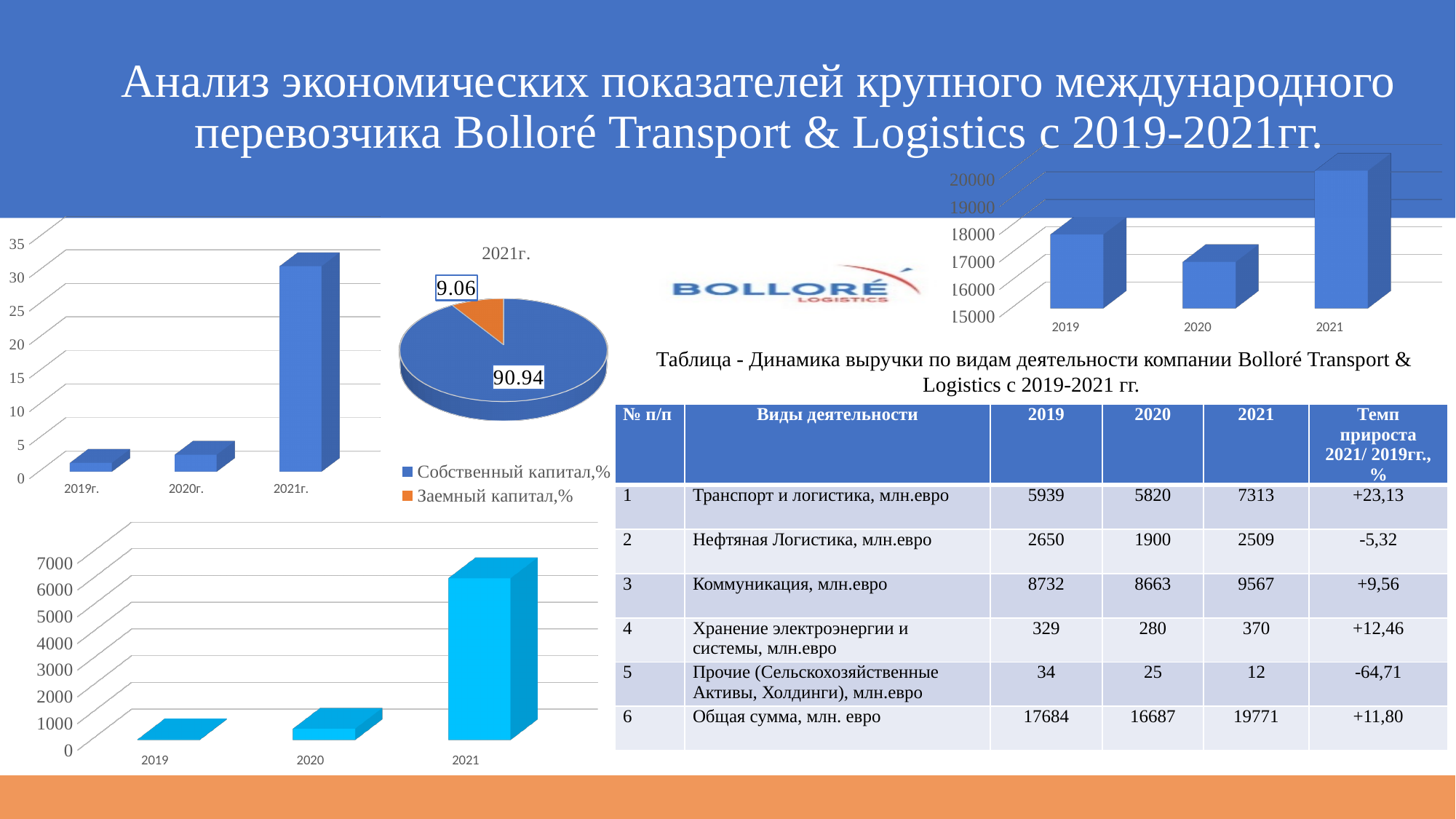
In the top-left bar chart with the axis from 0 to 35, which year has the highest bar? 2021г. In the pie chart titled 2021г., which slice is larger, Собственный капитал,% or Заемный капитал,%? Собственный капитал,% In the top-left bar chart with the axis from 0 to 35, is the value for 2021г. greater or less than 25? greater In the bottom-left bar chart with the axis from 0 to 7000, is the value for 2021 greater or less than 5000? greater In the pie chart titled 2021г., what is the value of the Заемный капитал,% slice? 9.06 In the top-right bar chart with the axis from 15000 to 20000, is the value for 2021 greater or less than 19000? greater How many entries does the legend of the pie chart titled 2021г. list? 2 In the pie chart titled 2021г., what is the value of the Собственный капитал,% slice? 90.94 In the top-right bar chart with the axis from 15000 to 20000, which year has the lowest bar? 2020 What kind of chart is the bottom-left chart with the axis from 0 to 7000? bar chart What kind of chart is the chart titled 2021г. in the upper middle of the slide? pie chart How many bars are in the top-left bar chart with the axis from 0 to 35? 3